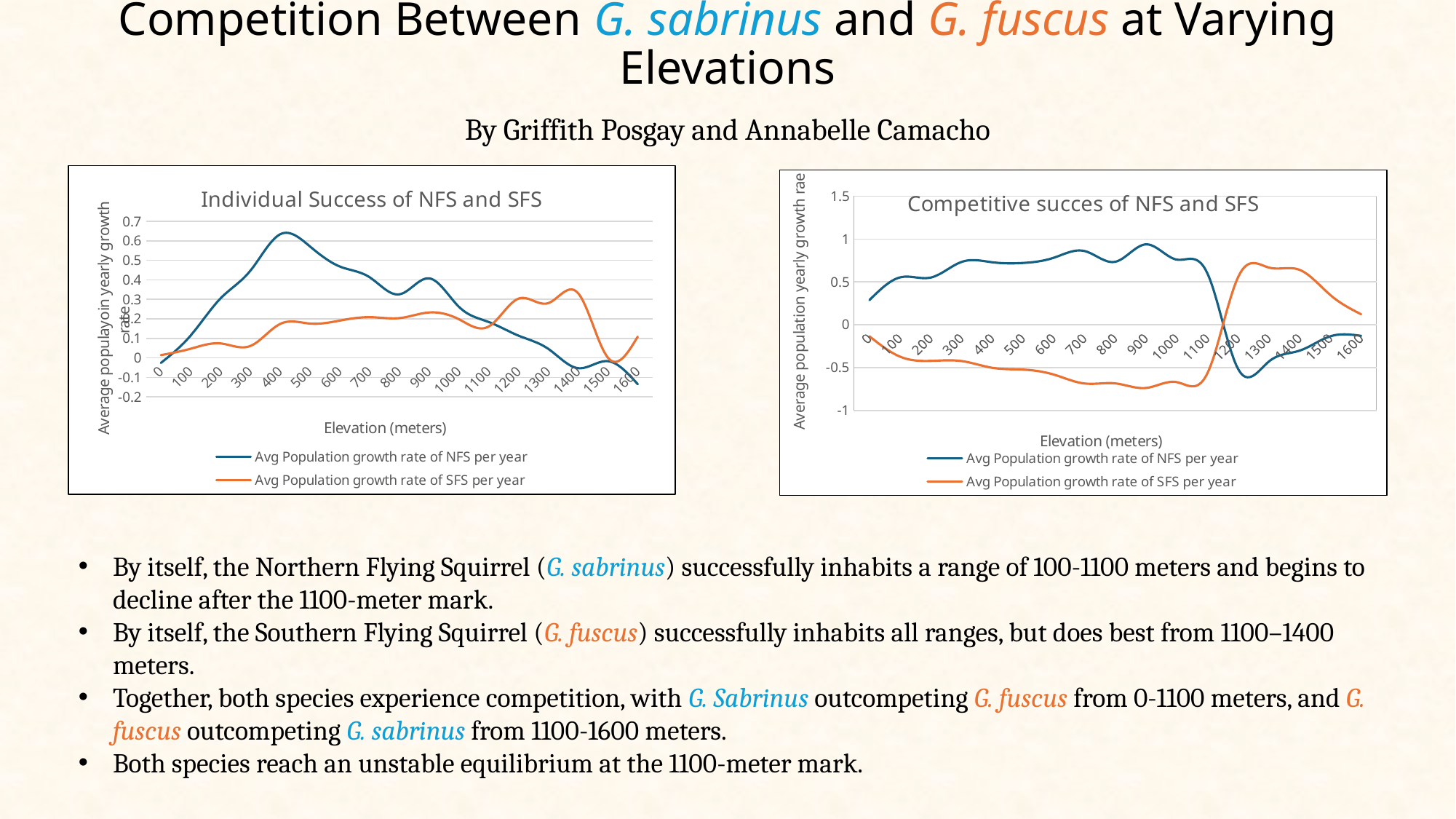
In the 'Competitive succes of NFS and SFS' chart, which series has the higher value at 500 meters, NFS or SFS? NFS In the 'Individual Success of NFS and SFS' chart, is the SFS growth rate at 400 meters greater or less than 0.3? less In the 'Individual Success of NFS and SFS' chart, is the NFS growth rate at 400 meters greater or less than 0.5? greater In the 'Competitive succes of NFS and SFS' chart, is the NFS growth rate at 900 meters greater or less than 0.5? greater What kind of chart is the 'Individual Success of NFS and SFS' chart? line chart How many series does the legend of the 'Competitive succes of NFS and SFS' chart list? 2 How many elevation points are marked along the x axis of the 'Individual Success of NFS and SFS' chart? 17 What is the x-axis label of the 'Competitive succes of NFS and SFS' chart? Elevation (meters) In the 'Competitive succes of NFS and SFS' chart, which series has the higher value at 1300 meters, NFS or SFS? SFS In the 'Individual Success of NFS and SFS' chart, which series has the higher value at 1300 meters, NFS or SFS? SFS